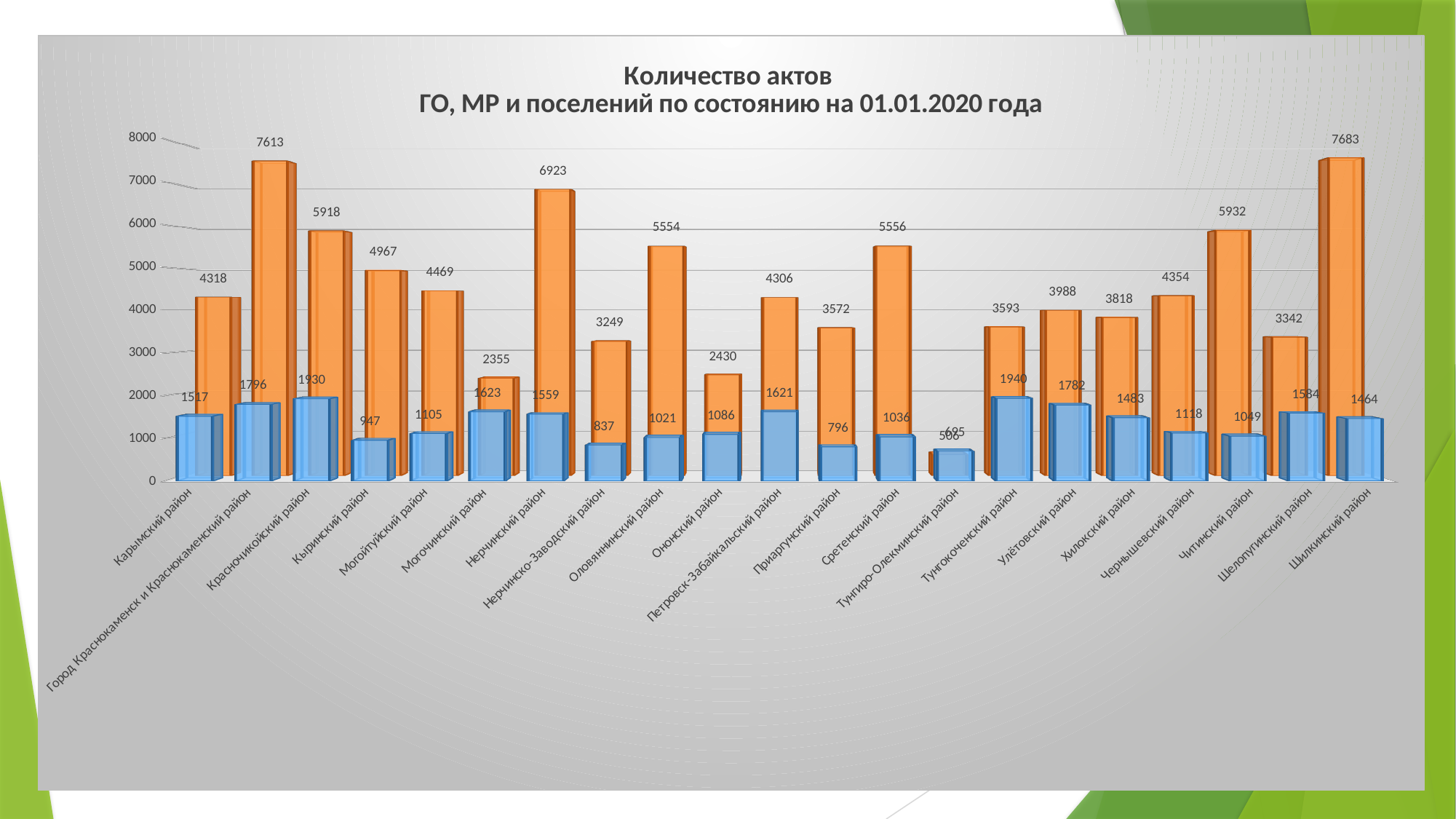
Which district has the lowest orange bar? Тунгиро-Олекминский район What is the difference between the orange and blue bars for Шилкинский район? 6219 What is the value of the blue bar for Красночикойский район? 1930 What kind of chart is shown on the slide? bar chart What is the value of the orange bar for Шилкинский район? 7683 Which district has the highest orange bar? Шилкинский район What is the title of the chart? Количество актов ГО, МР и поселений по состоянию на 01.01.2020 года Which is larger: the orange bar for Нерчинский район or the orange bar for Красночикойский район? Нерчинский район What is the difference between the orange bars for Город Краснокаменск и Краснокаменский район and Карымский район? 3295 Which district has the highest blue bar? Тунгокоченский район What is the value of the orange bar for Нерчинский район? 6923 How many districts (categories) are shown on the x axis of the chart? 21